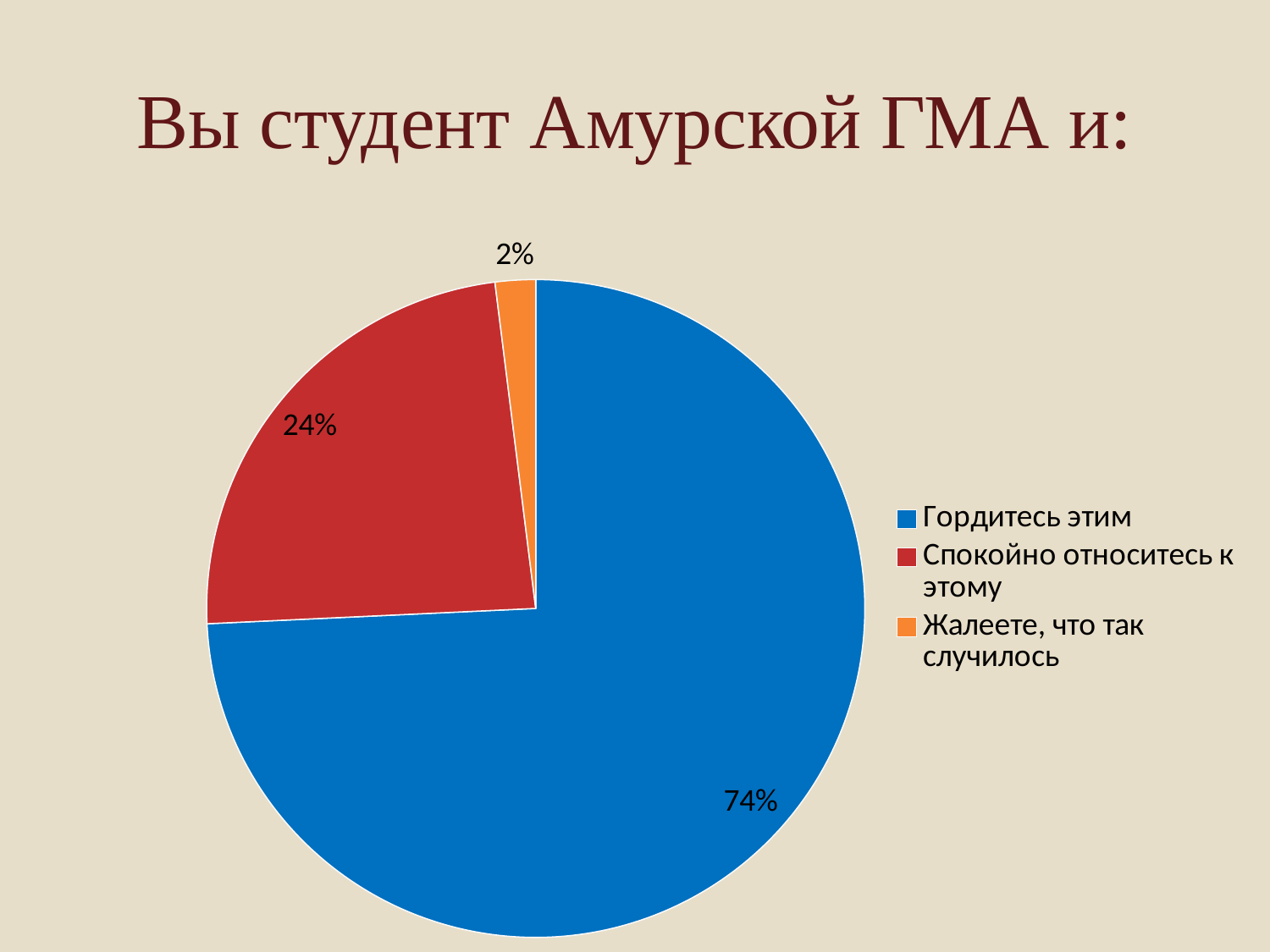
What share of the pie does "Гордитесь этим" have? 74% What is the title of the slide? Вы студент Амурской ГМА и: What share of the pie does "Спокойно относитесь к этому" have? 24% What colour is the slice for "Гордитесь этим"? Blue How many categories does the pie chart show? 3 Which category has the smallest slice of the pie? Жалеете, что так случилось What is the difference in percentage points between "Гордитесь этим" and "Спокойно относитесь к этому"? 50 What is the difference in percentage points between "Спокойно относитесь к этому" and "Жалеете, что так случилось"? 22 What kind of chart is shown on the slide? Pie chart Which is larger: the slice for "Спокойно относитесь к этому" or the slice for "Жалеете, что так случилось"? Спокойно относитесь к этому What share of the pie does "Жалеете, что так случилось" have? 2% Which category has the largest slice of the pie? Гордитесь этим